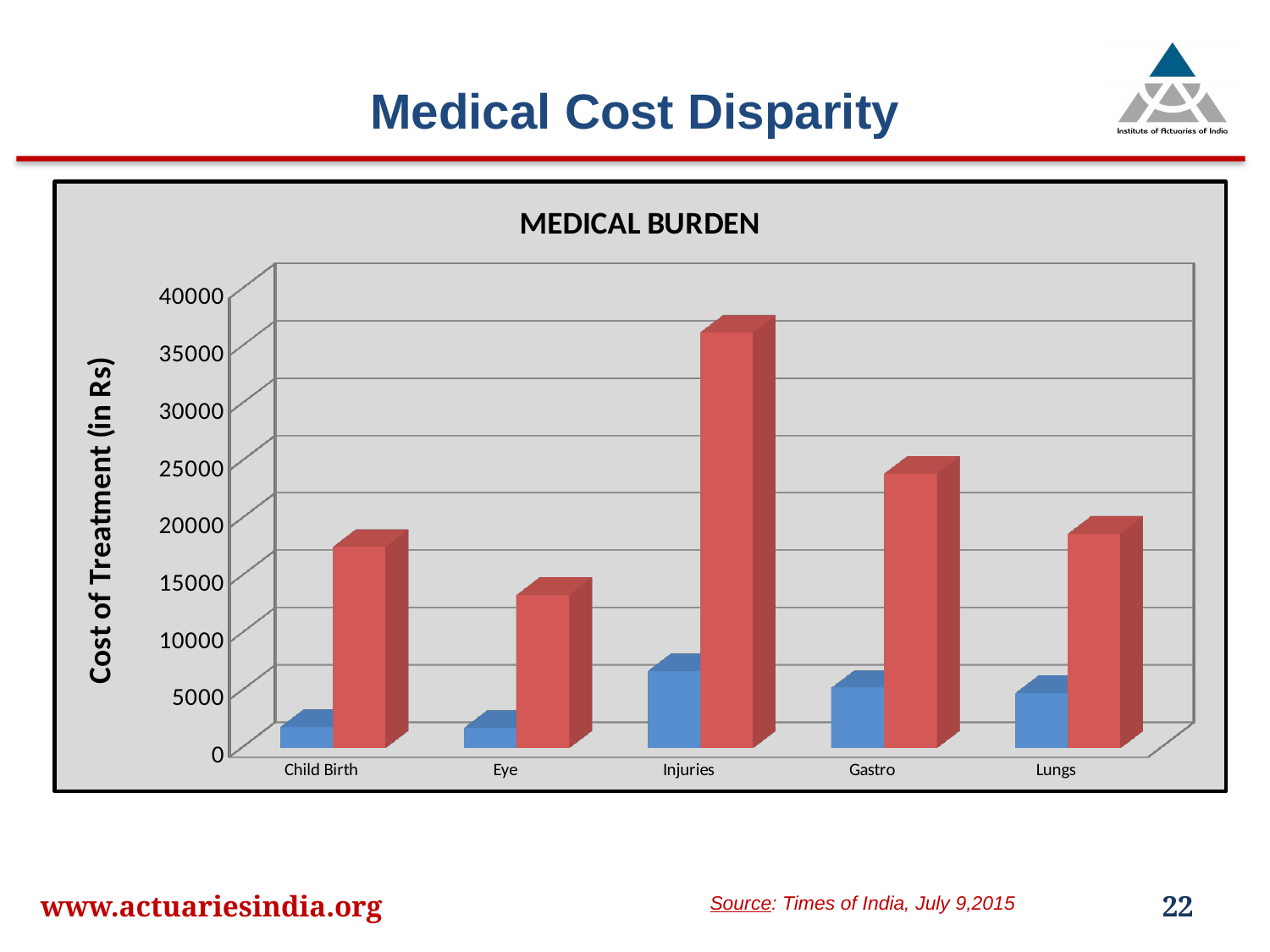
Which has the larger red bar, Gastro or Lungs? Gastro Is the red bar for Injuries greater or less than 30000? greater Is the blue bar for Child Birth greater or less than 5000? less Which category has the shortest red bar? Eye Which category has the tallest blue bar? Injuries What is the label on the vertical axis of the chart? Cost of Treatment (in Rs) What kind of chart is shown on the slide? bar chart Which category has the tallest red bar? Injuries How many categories are shown on the x axis of the chart? 5 Is the red bar for Gastro greater or less than 20000? greater Which has the larger red bar, Child Birth or Eye? Child Birth What is the title of the chart? MEDICAL BURDEN